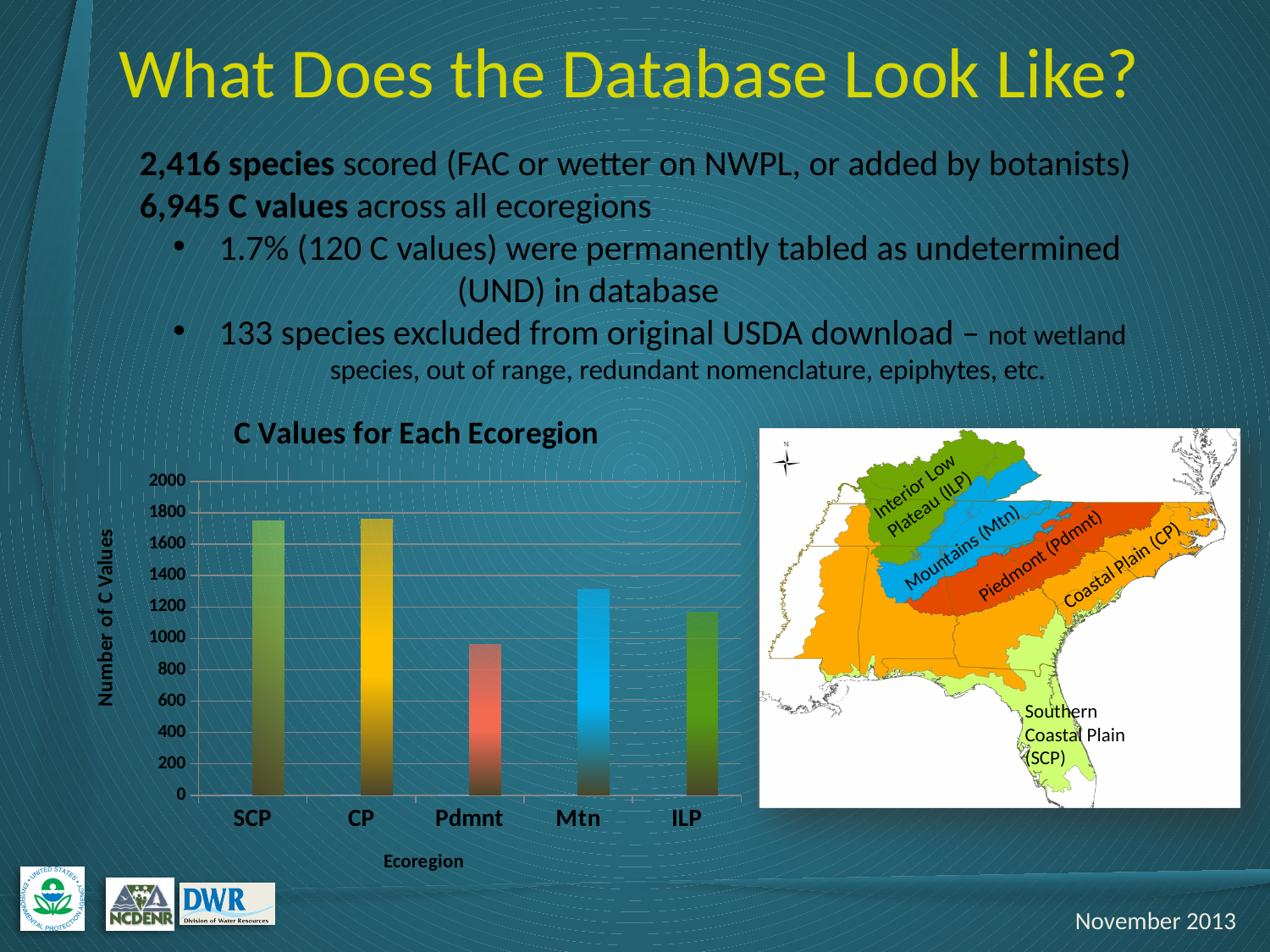
Which has more C values, Mtn or Pdmnt? Mtn What is the highest tick value shown on the y axis of the bar chart? 2000 Is the value for CP greater or less than 1600? greater Is the value for Mtn greater or less than 1200? greater Is the value for Pdmnt greater or less than 1000? less What is the title of the y axis on the bar chart? Number of C Values Which has more C values, CP or ILP? CP Which ecoregion has the lowest number of C values in the chart? Pdmnt How many ecoregions are shown on the x axis of the 'C Values for Each Ecoregion' chart? 5 What kind of chart is 'C Values for Each Ecoregion'? bar chart